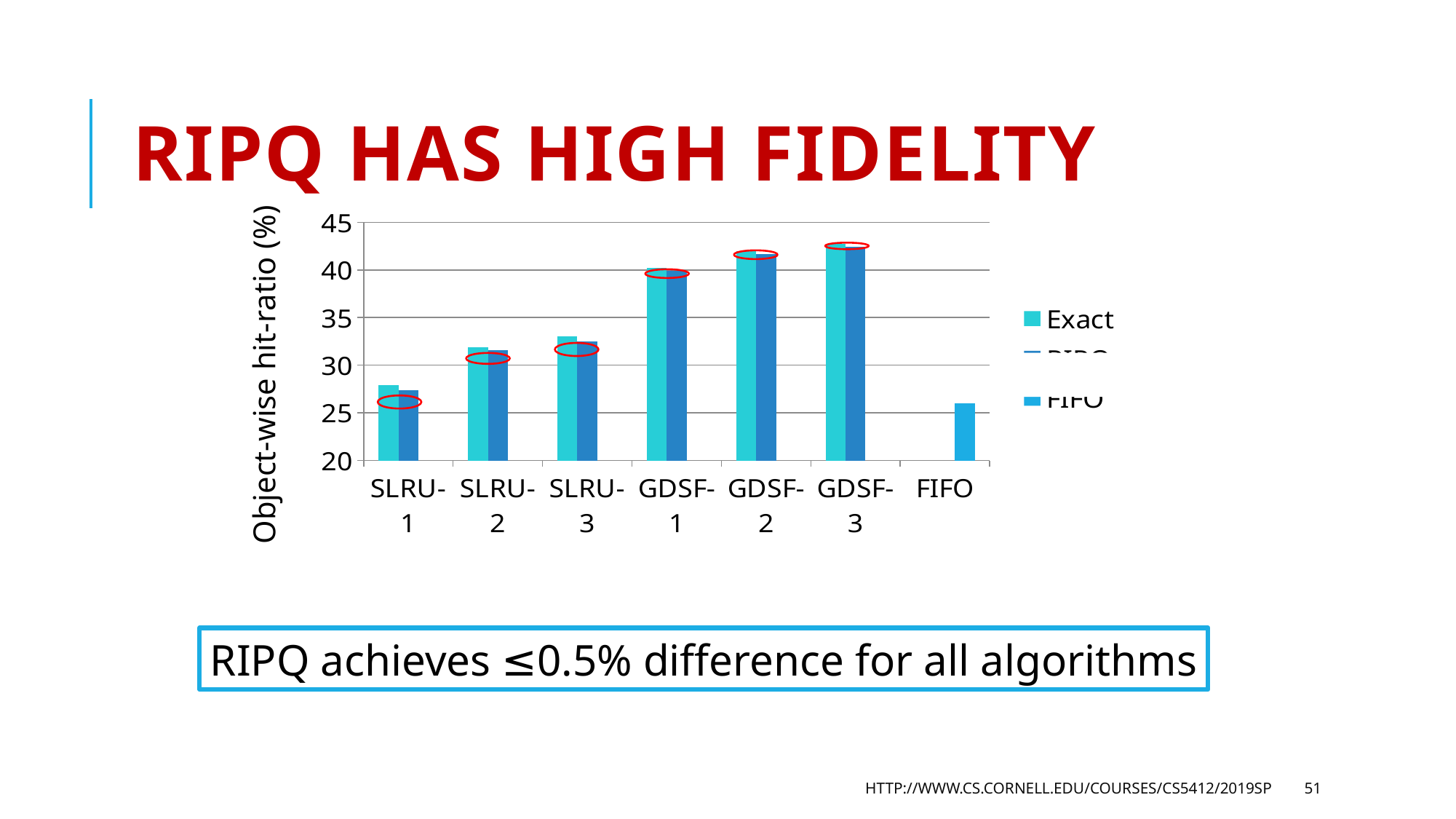
How many series does the chart's legend list? 3 Is the Exact value for GDSF-3 greater or less than 40? greater What kind of chart is shown on the slide? bar chart What is the label of the y axis? Object-wise hit-ratio (%) Which category has the highest Exact hit-ratio? GDSF-3 Do the Exact values rise or fall from GDSF-1 to GDSF-3? rise Is the Exact value for SLRU-2 greater or less than 30? greater How many categories are shown on the x axis of the chart? 7 Is the FIFO value greater or less than 30? less Which has the larger Exact hit-ratio, SLRU-3 or GDSF-1? GDSF-1 Which category has the lowest Exact hit-ratio? SLRU-1